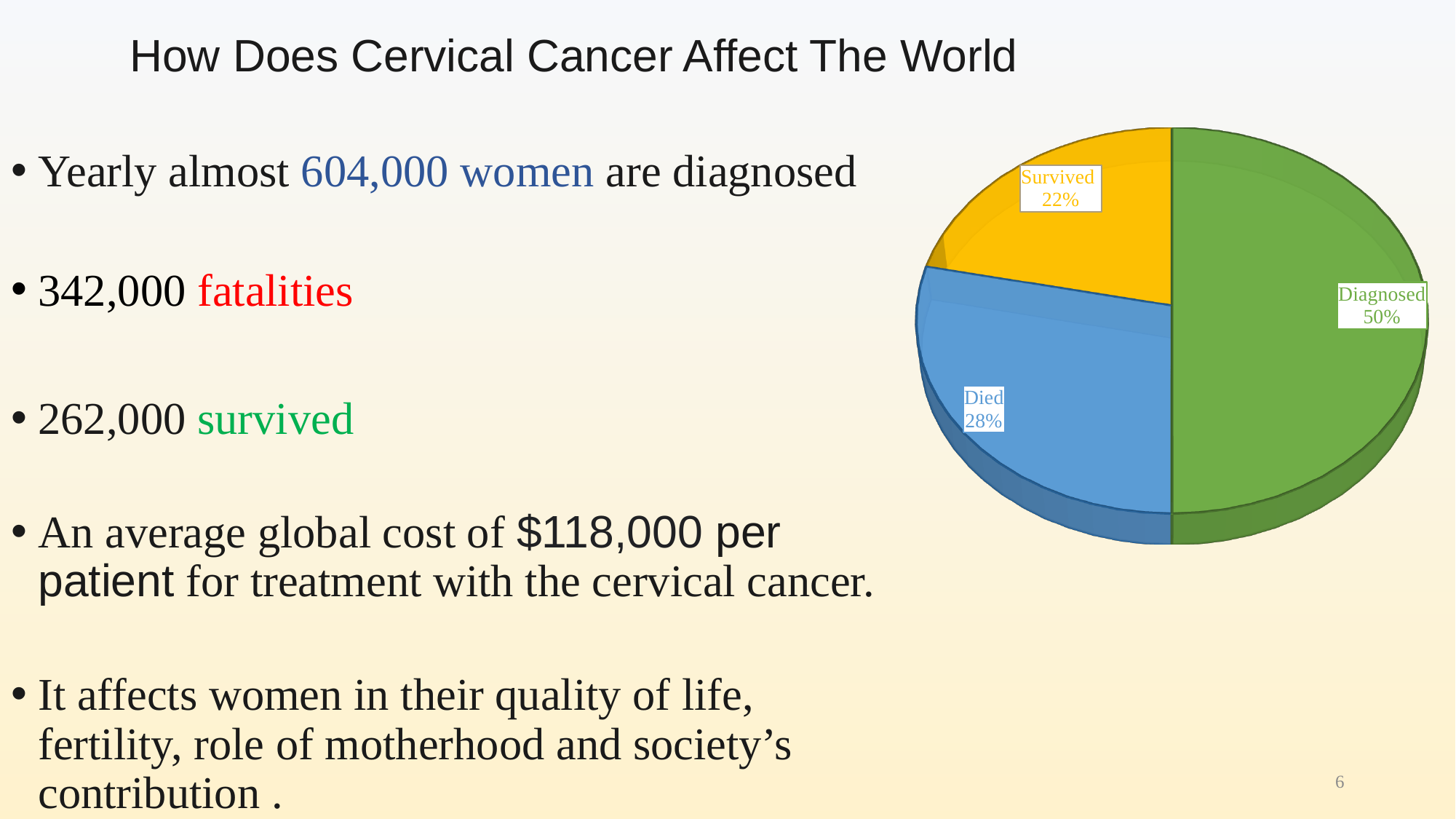
What colour is the Diagnosed slice? Green Which slice of the pie chart is the largest? Diagnosed Which slice is larger, Died or Survived? Died What kind of chart is shown on the slide? Pie chart What percentage does the Diagnosed slice show? 50% What colour is the Died slice? Blue Which slice of the pie chart is the smallest? Survived What is the difference in percentage points between the Died and Survived slices? 6 What percentage does the Died slice show? 28% What percentage does the Survived slice show? 22% How many slices does the pie chart have? 3 What is the difference in percentage points between the Diagnosed and Died slices? 22